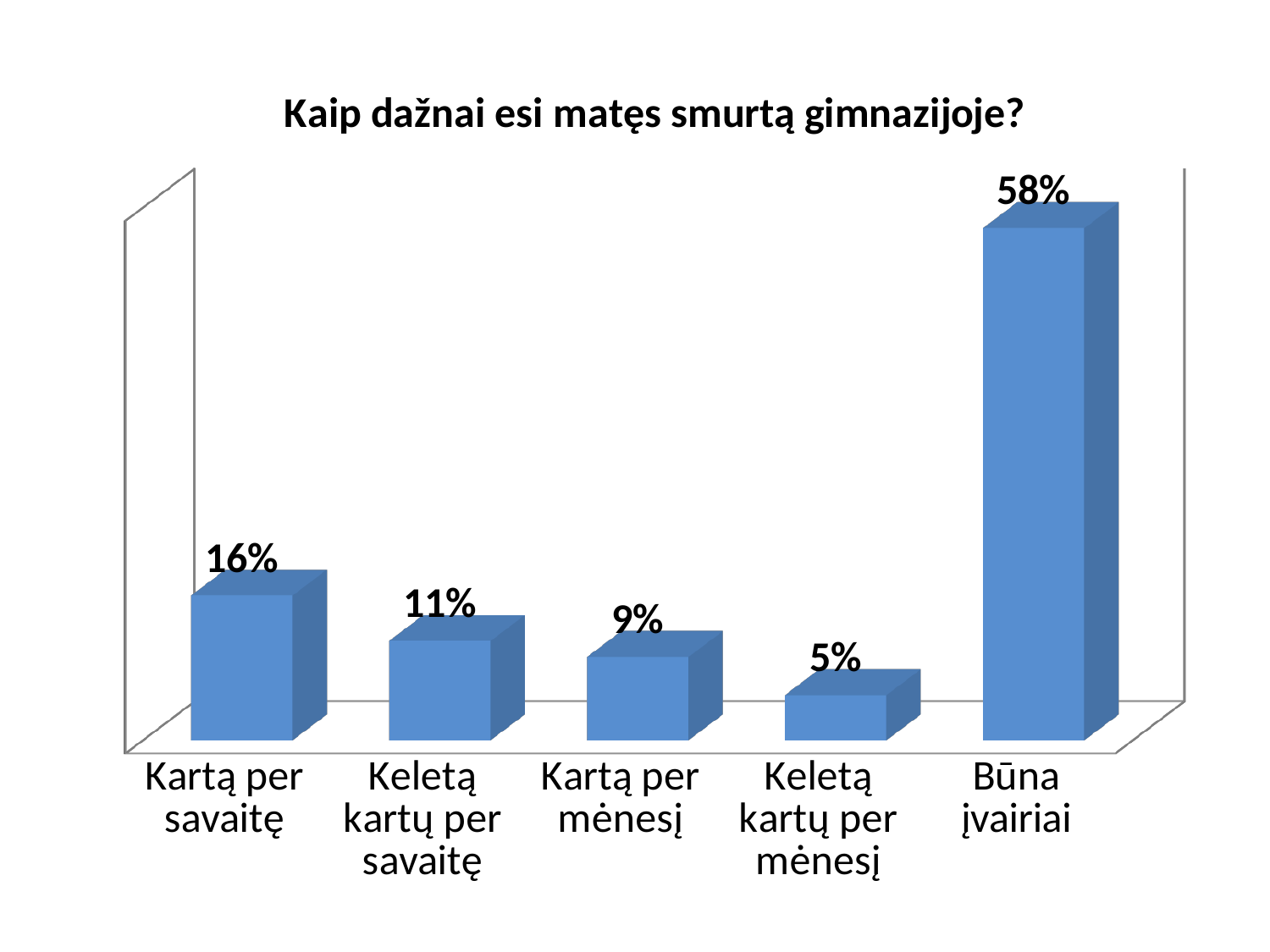
How many categories are shown in the chart? 5 What is the value for "Keletą kartų per mėnesį"? 5% Which category has the highest value? Būna įvairiai What is the value for "Kartą per savaitę"? 16% What is the difference between the values for "Būna įvairiai" and "Kartą per savaitę"? 42% What is the difference between the values for "Keletą kartų per savaitę" and "Kartą per mėnesį"? 2% What is the value for "Kartą per mėnesį"? 9% Which category has the lowest value? Keletą kartų per mėnesį What is the value for "Keletą kartų per savaitę"? 11% Which is larger, the value for "Kartą per savaitę" or the value for "Keletą kartų per mėnesį"? Kartą per savaitę What is the value for "Būna įvairiai"? 58% What kind of chart is this? Bar chart